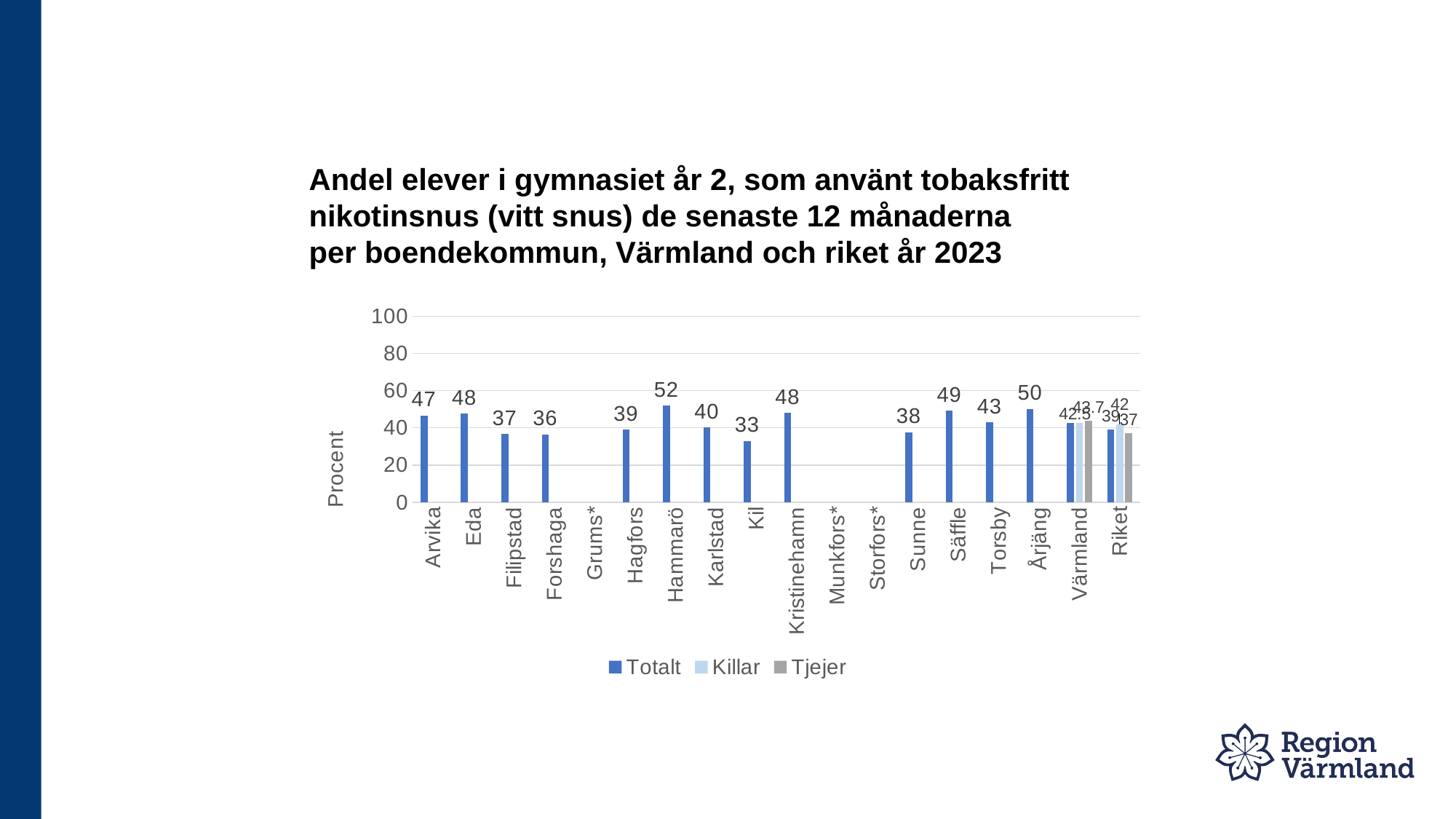
What is the Totalt value for Kil? 33 What is the Totalt value for Hammarö? 52 What is the label on the vertical axis? Procent How many series does the legend list? 3 What is the Killar value for Riket? 42 Which municipality has the highest Totalt value? Hammarö What kind of chart is shown on the slide? Bar chart What is the Tjejer value for Riket? 37 Which municipality with a plotted bar has the lowest Totalt value? Kil Is the Totalt value for Årjäng greater or less than 40? greater Which has a higher Totalt value, Säffle or Torsby? Säffle What is the difference between the Totalt values for Hammarö and Kil? 19